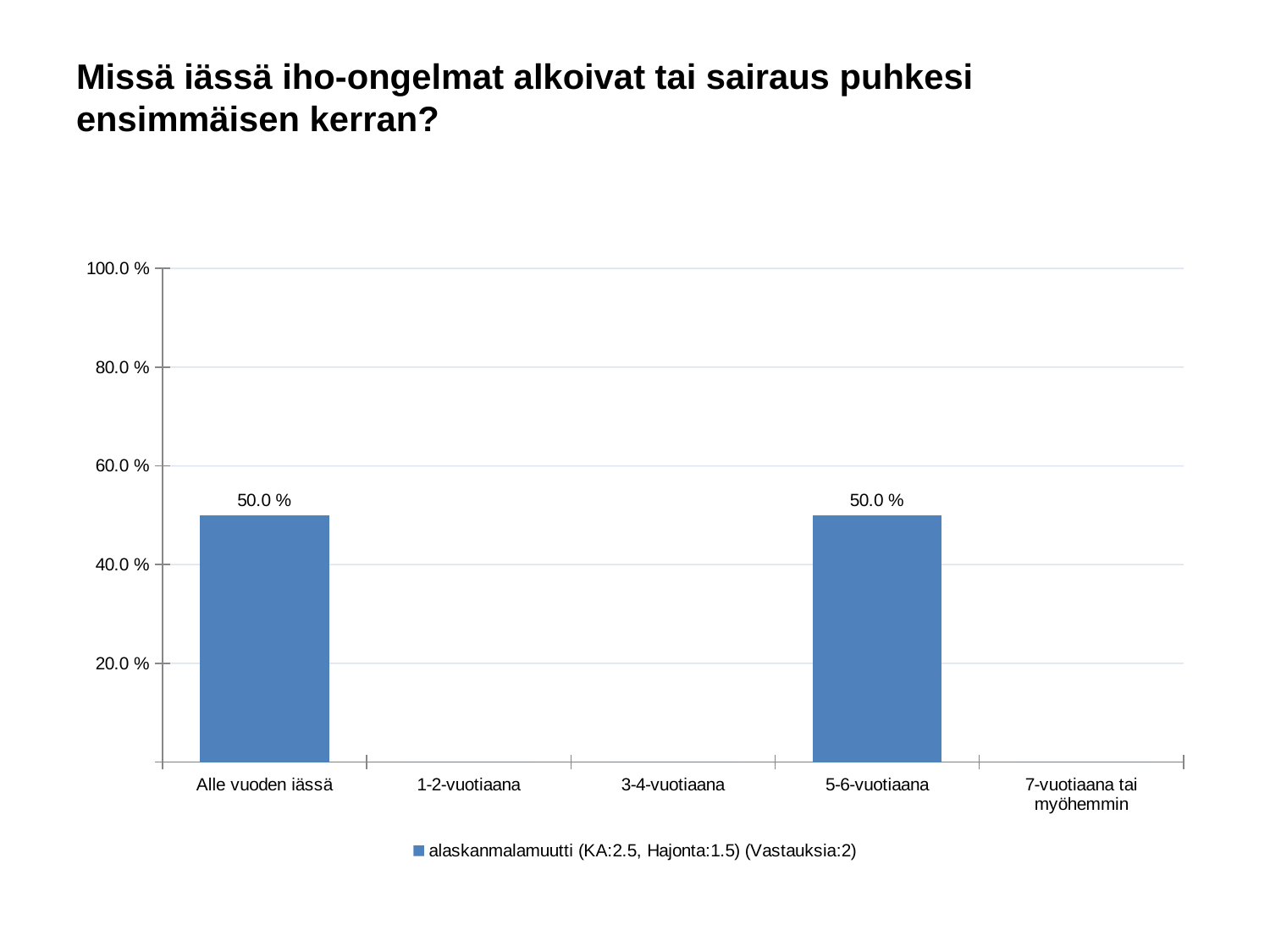
How many categories have a visible bar? 2 What is the value for "Alle vuoden iässä"? 50.0 % What kind of chart is shown on the slide? Bar chart What is the difference between the values for "Alle vuoden iässä" and "5-6-vuotiaana"? 0.0 % What is the name of the series in the legend? alaskanmalamuutti (KA:2.5, Hajonta:1.5) (Vastauksia:2) How many categories are shown on the x axis? 5 What is the highest value shown on the y axis? 100.0 % Is the value for "5-6-vuotiaana" greater or less than 40.0 %? greater How many series does the legend list? 1 Is the value for "Alle vuoden iässä" greater or less than 60.0 %? less What is the value for "5-6-vuotiaana"? 50.0 %